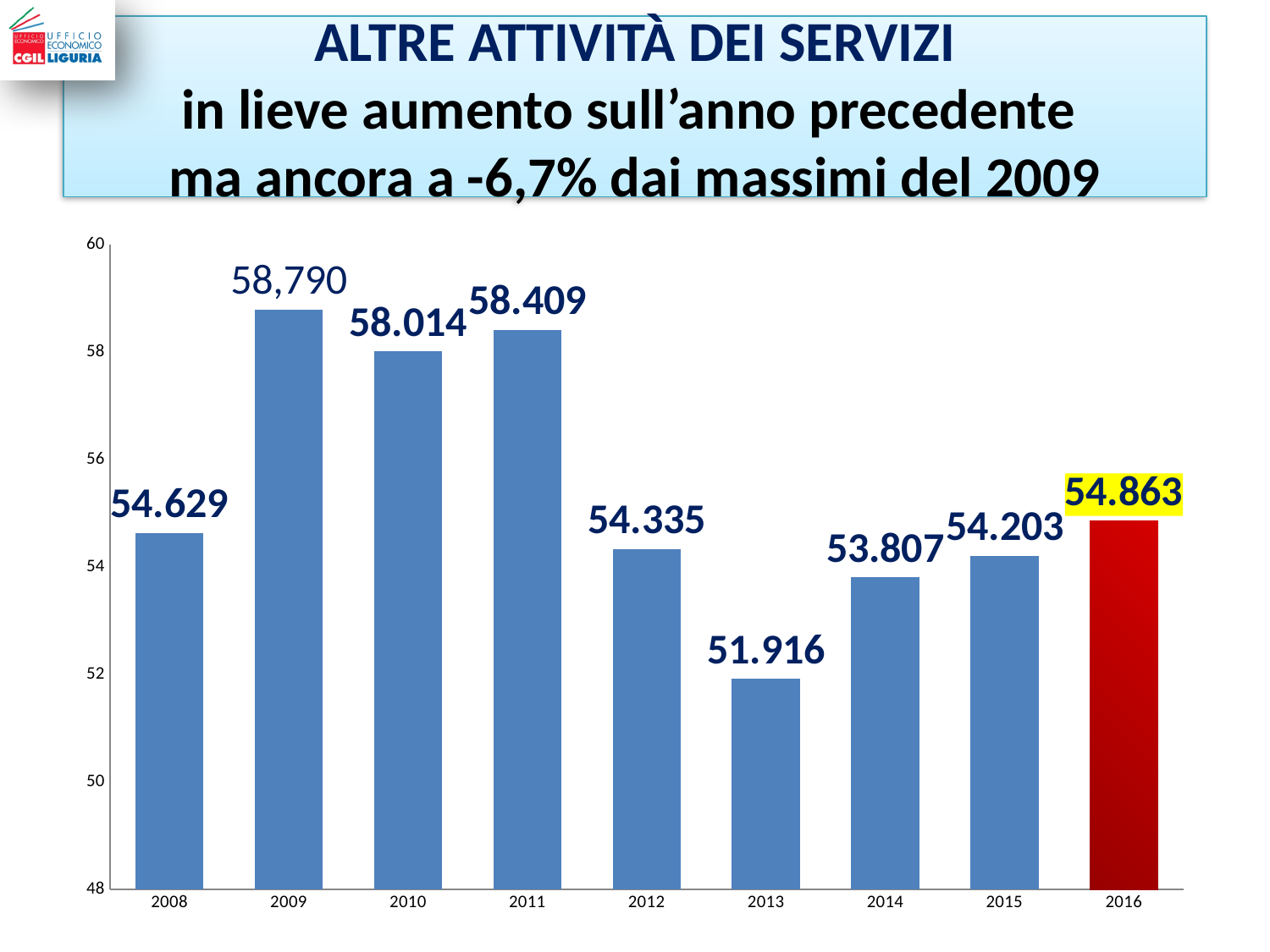
What is the value for 2013? 51.916 Is the value for 2014 greater or less than 54? less What kind of chart is shown on the slide? bar chart What is the value for 2016? 54.863 Is the value for 2013 greater or less than 52? less What is the value for 2009? 58,790 How many years are shown on the x axis? 9 Which bar is coloured red instead of blue? 2016 Which year has the highest value? 2009 What is the value for 2011? 58.409 Which is larger, the value for 2010 or the value for 2011? 2011 Which year has the lowest value? 2013